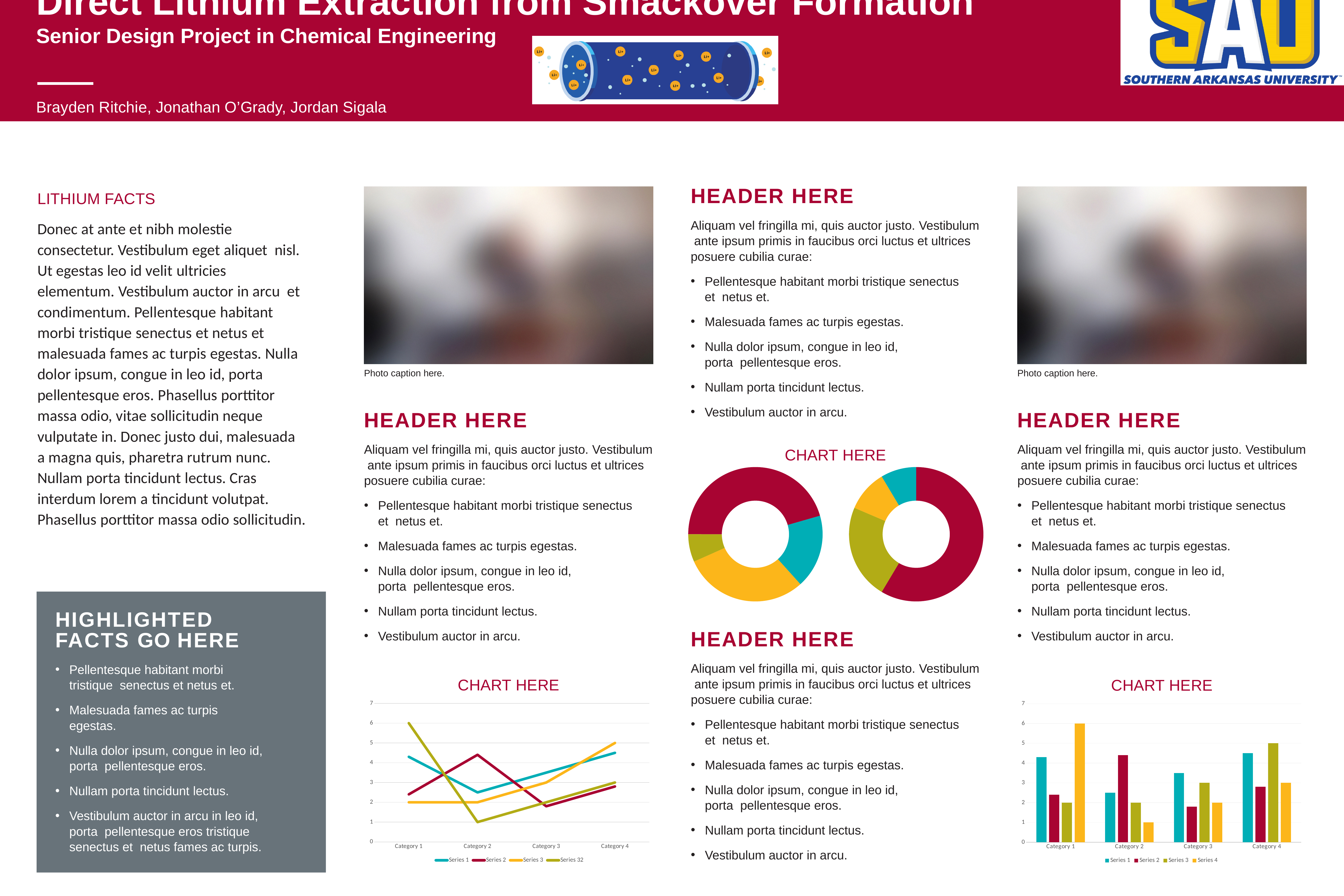
In the bottom-right bar chart, which category has the tallest bar overall? Category 1 How many donut charts are shown under the 'CHART HERE' title in the middle column? 2 How many series does the legend of the bottom-right bar chart list? 4 What kind of chart is the chart at the bottom of the second column (below the left 'HEADER HERE' text)? line chart In the bottom-right bar chart, is the value for Series 4 in Category 2 greater or less than 2? less How many categories are shown on the x axis of the line chart in the second column? 4 How many categories are shown on the x axis of the bottom-right bar chart? 4 In the bottom-right bar chart, is the value for Series 4 in Category 1 greater or less than 5? greater In the line chart in the second column, does Series 3 rise or fall from Category 2 to Category 4? rise What kind of chart is the chart at the bottom right of the slide? bar chart In the bottom-right bar chart, which is larger in Category 3: Series 1 or Series 2? Series 1 In the line chart in the second column, is the value for Series 3 at Category 4 greater or less than 4? greater